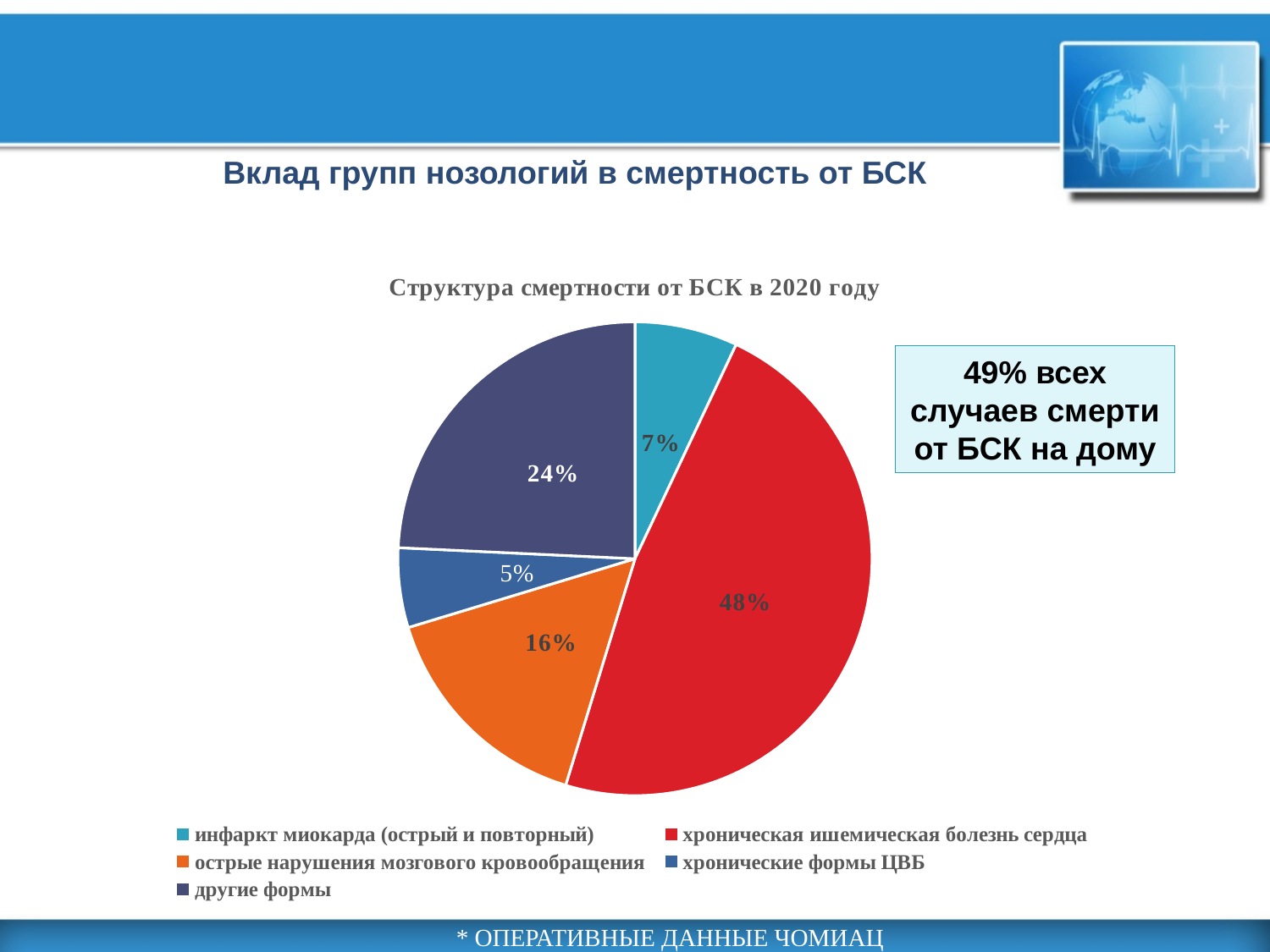
What is the difference in percentage points between другие формы and острые нарушения мозгового кровообращения? 8 Which category has the largest share of the pie? хроническая ишемическая болезнь сердца Which is larger: the share for инфаркт миокарда (острый и повторный) or the share for хронические формы ЦВБ? инфаркт миокарда (острый и повторный) What share of the pie is другие формы? 24% What share of the pie is хронические формы ЦВБ? 5% What share of the pie is острые нарушения мозгового кровообращения? 16% What kind of chart is shown on the slide? pie chart Which category has the smallest share of the pie? хронические формы ЦВБ How many slices does the pie chart have? 5 What is the title of the chart? Структура смертности от БСК в 2020 году